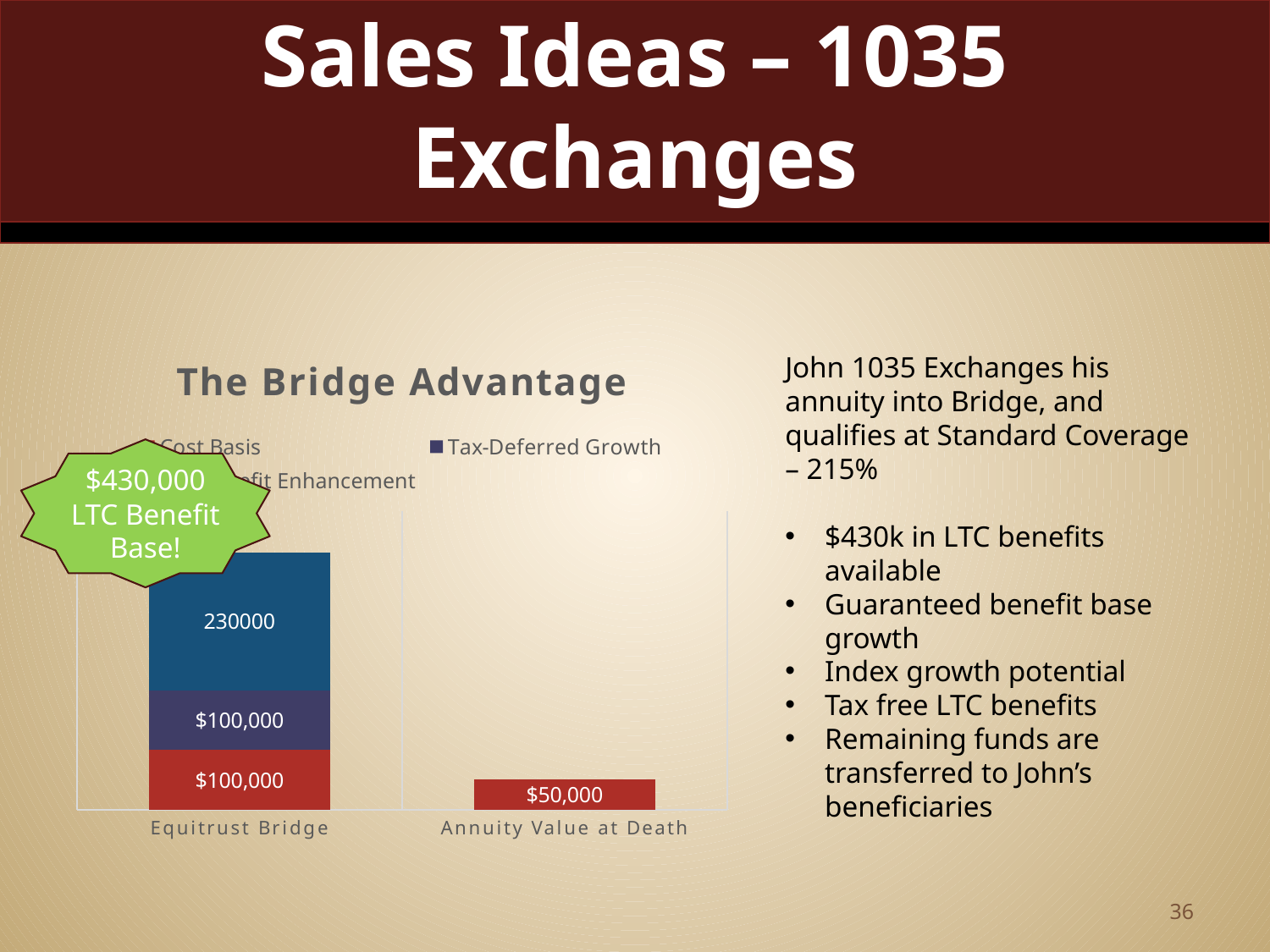
What is the title of the chart? The Bridge Advantage Which bar is taller, Equitrust Bridge or Annuity Value at Death? Equitrust Bridge What is the difference between the Cost Basis for Equitrust Bridge and the Annuity Value at Death? $50,000 How many series does the legend list? 3 What is the Tax-Deferred Growth value for Equitrust Bridge? $100,000 What value is labelled on the top (blue) segment of the Equitrust Bridge bar? 230000 What type of chart is shown on the slide? Stacked bar chart How many categories are shown on the x axis? 2 What is the total of the stacked Equitrust Bridge bar? $430,000 What value is shown for Annuity Value at Death? $50,000 What colour represents Cost Basis in the chart? Red What is the Cost Basis value for Equitrust Bridge? $100,000